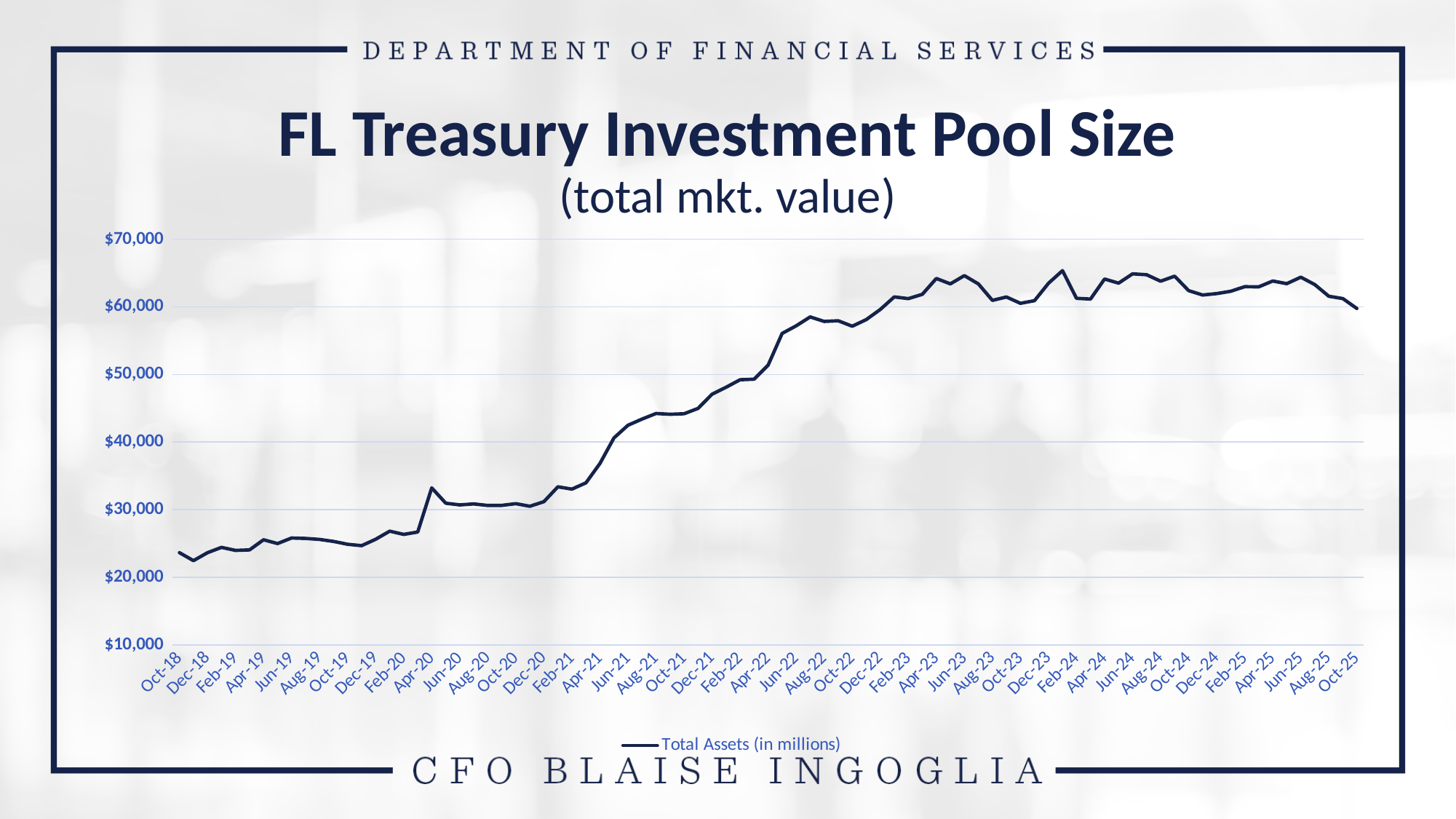
What is the title of the chart? FL Treasury Investment Pool Size (total mkt. value) Is the value for Oct-21 greater or less than $50,000? less Which is larger, the value for Apr-20 or the value for Apr-22? Apr-22 How many series does the legend list? 1 What is the legend entry for the plotted line? Total Assets (in millions) Is the value for Apr-20 greater or less than $30,000? greater What kind of chart is shown on the slide? Line chart Is the value for Jun-22 greater or less than $50,000? greater Which is larger, the value for Oct-18 or the value for Oct-25? Oct-25 Overall, do the values rise or fall from Oct-18 to Oct-25? Rise